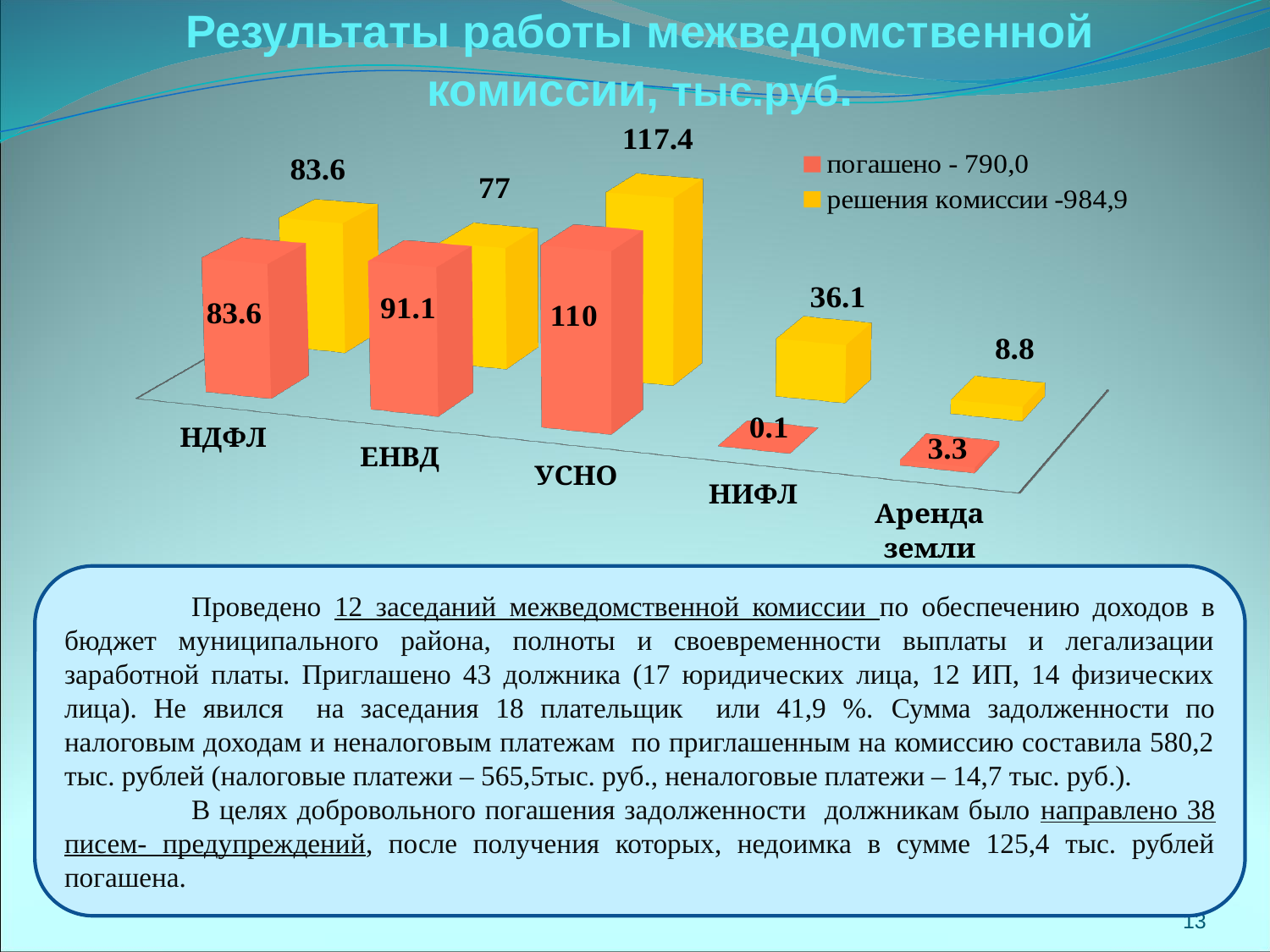
What is the difference between the 'решения комиссии' and 'погашено' values for ЕНВД? 14.1 What is the value of the 'погашено' series for УСНО? 110 What kind of chart is shown on the slide? bar chart How many categories are shown on the x axis of the chart? 5 For НИФЛ, which is larger: the 'погашено' value or the 'решения комиссии' value? решения комиссии What colour are the bars of the 'решения комиссии' series? yellow Which category has the highest value in the 'решения комиссии' series? УСНО What is the total of the 'погашено' and 'решения комиссии' values for Аренда земли? 12.1 How many series does the chart legend list? 2 What is the value of the 'погашено' series for Аренда земли? 3.3 What is the value of the 'решения комиссии' series for НИФЛ? 36.1 Which category has the lowest value in the 'погашено' series? НИФЛ